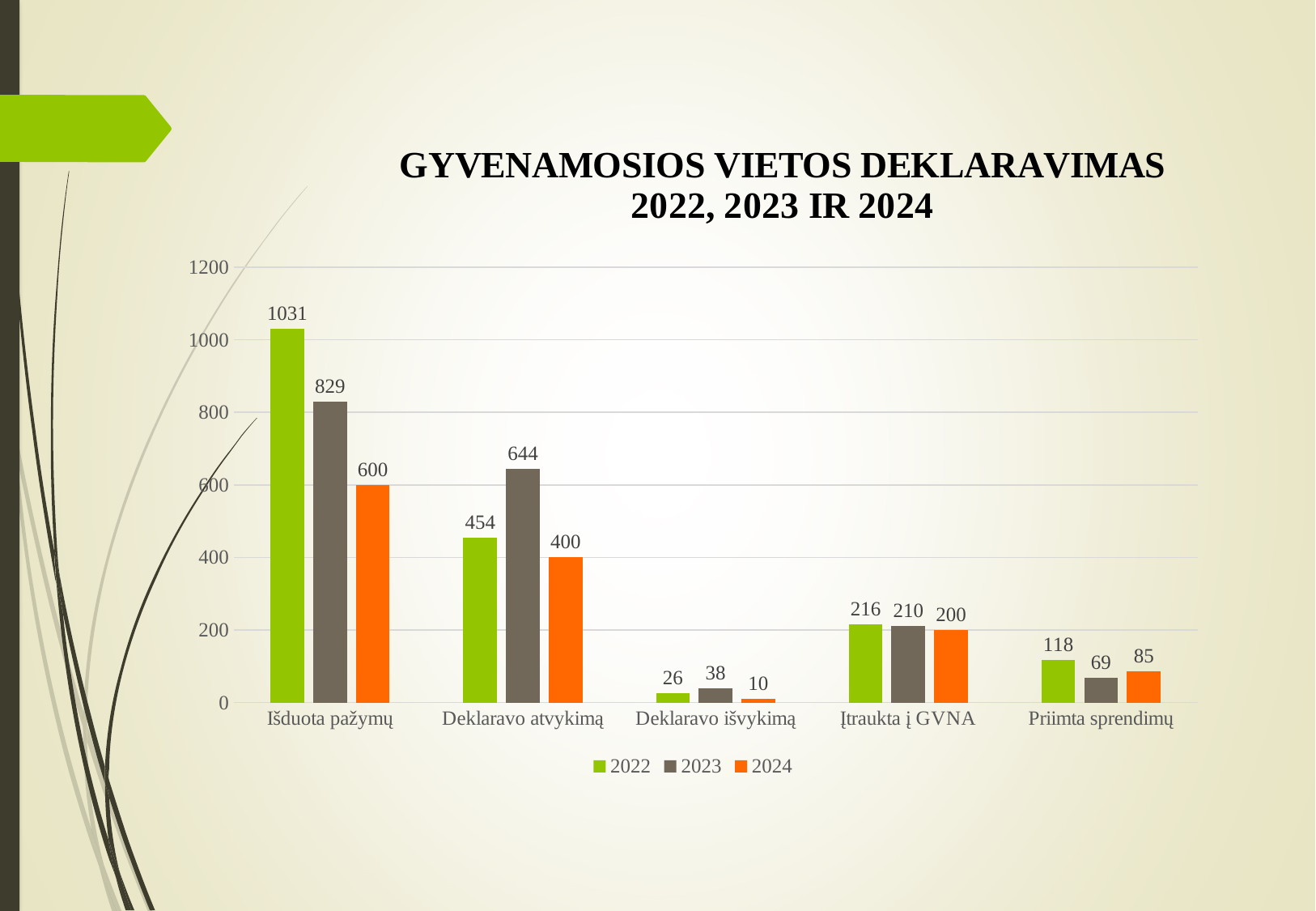
What is the value for 2024 in the Deklaravo atvykimą category? 400 Do the values for Įtraukta į GVNA rise or fall from 2022 to 2024? Fall Which category has the highest value for the 2023 series? Išduota pažymų Which category has the lowest value for the 2024 series? Deklaravo išvykimą What is the value for 2022 in the Išduota pažymų category? 1031 How many categories are shown on the x axis? 5 How many series does the legend list? 3 What is the difference between the 2022 and 2024 values for Išduota pažymų? 431 What kind of chart is shown on the slide? Bar chart What is the title of the chart? GYVENAMOSIOS VIETOS DEKLARAVIMAS 2022, 2023 IR 2024 What is the value for 2023 in the Priimta sprendimų category? 69 Which is larger in the Deklaravo atvykimą category: the 2022 value or the 2023 value? 2023